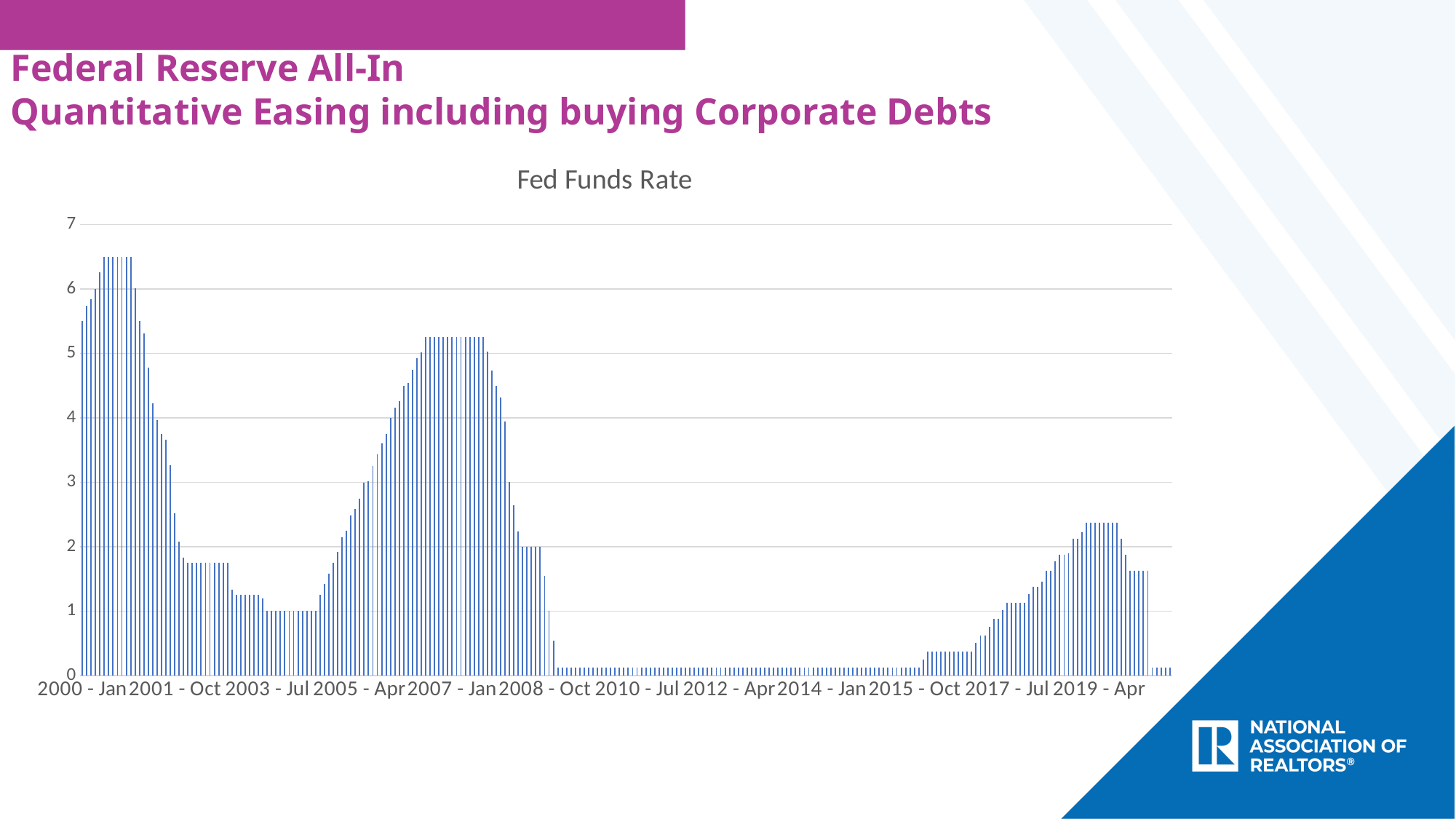
Is the value at 2012 - Apr greater or less than 1? less What kind of chart is shown on the slide? bar chart How many labels are shown along the x axis? 12 Is the value at 2000 - Jan greater or less than 5? greater Which is larger, the value at 2001 - Oct or the value at 2014 - Jan? 2001 - Oct Do the values rise or fall between 2015 - Oct and 2019 - Apr? rise What is the highest value shown on the vertical axis? 7 Which is larger, the value at 2007 - Jan or the value at 2019 - Apr? 2007 - Jan Do the values rise or fall between 2000 - Jan and 2003 - Jul? fall Is the value at 2019 - Apr greater or less than 3? less What is the title of the chart? Fed Funds Rate